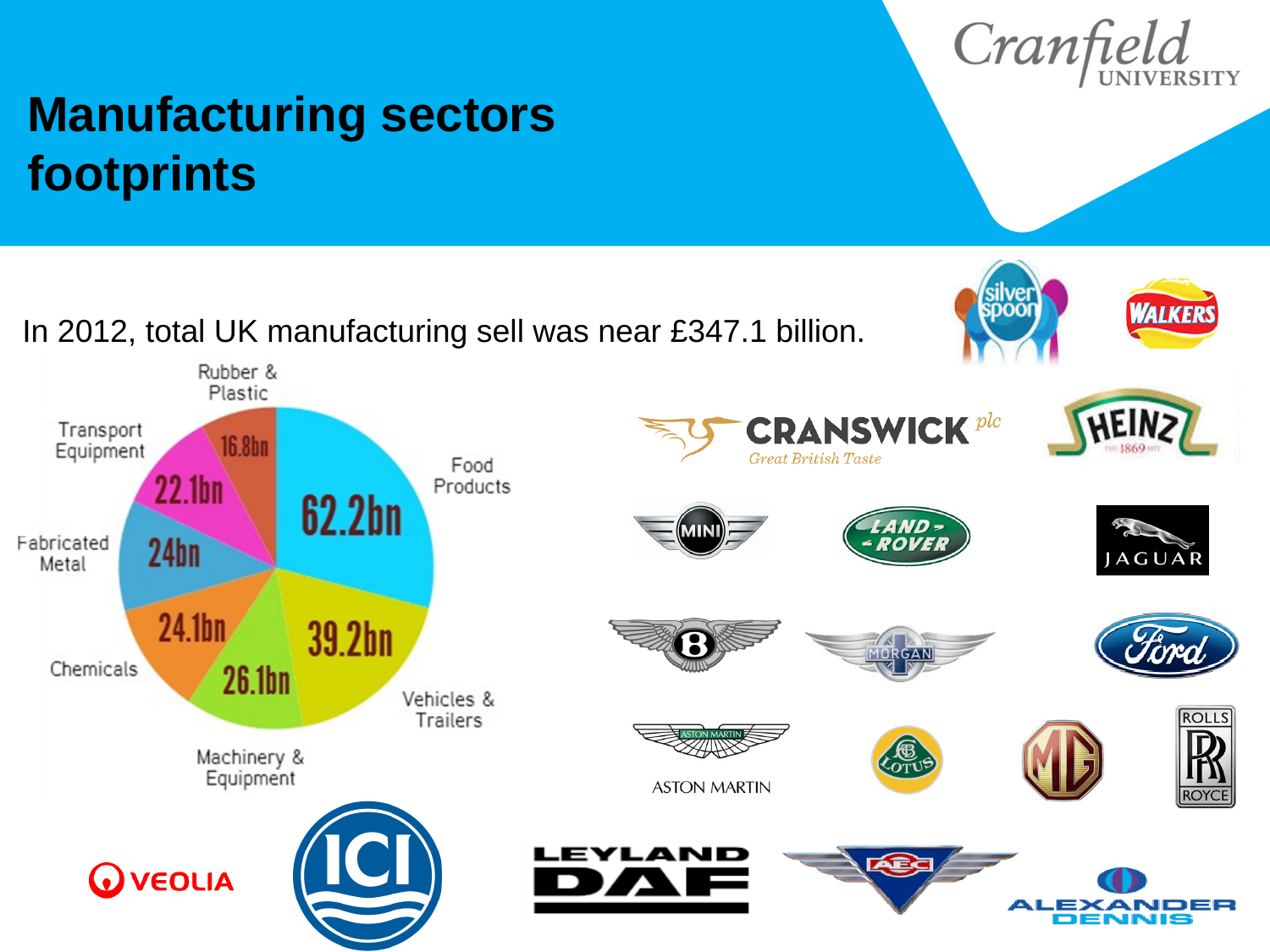
What is the value for Chemicals in the pie chart? 24.1bn What is the value for Food Products in the pie chart? 62.2bn What is the value for Transport Equipment in the pie chart? 22.1bn How many sectors are shown in the pie chart? 7 Which sector has the smallest slice in the pie chart? Rubber & Plastic Which sector has the largest slice in the pie chart? Food Products Which is larger in the pie chart, Transport Equipment or Machinery & Equipment? Machinery & Equipment What is the difference between the Food Products value and the Vehicles & Trailers value? 23bn What is the value for Machinery & Equipment in the pie chart? 26.1bn What kind of chart is shown on the slide? pie chart What is the value for Vehicles & Trailers in the pie chart? 39.2bn What is the value for Rubber & Plastic in the pie chart? 16.8bn